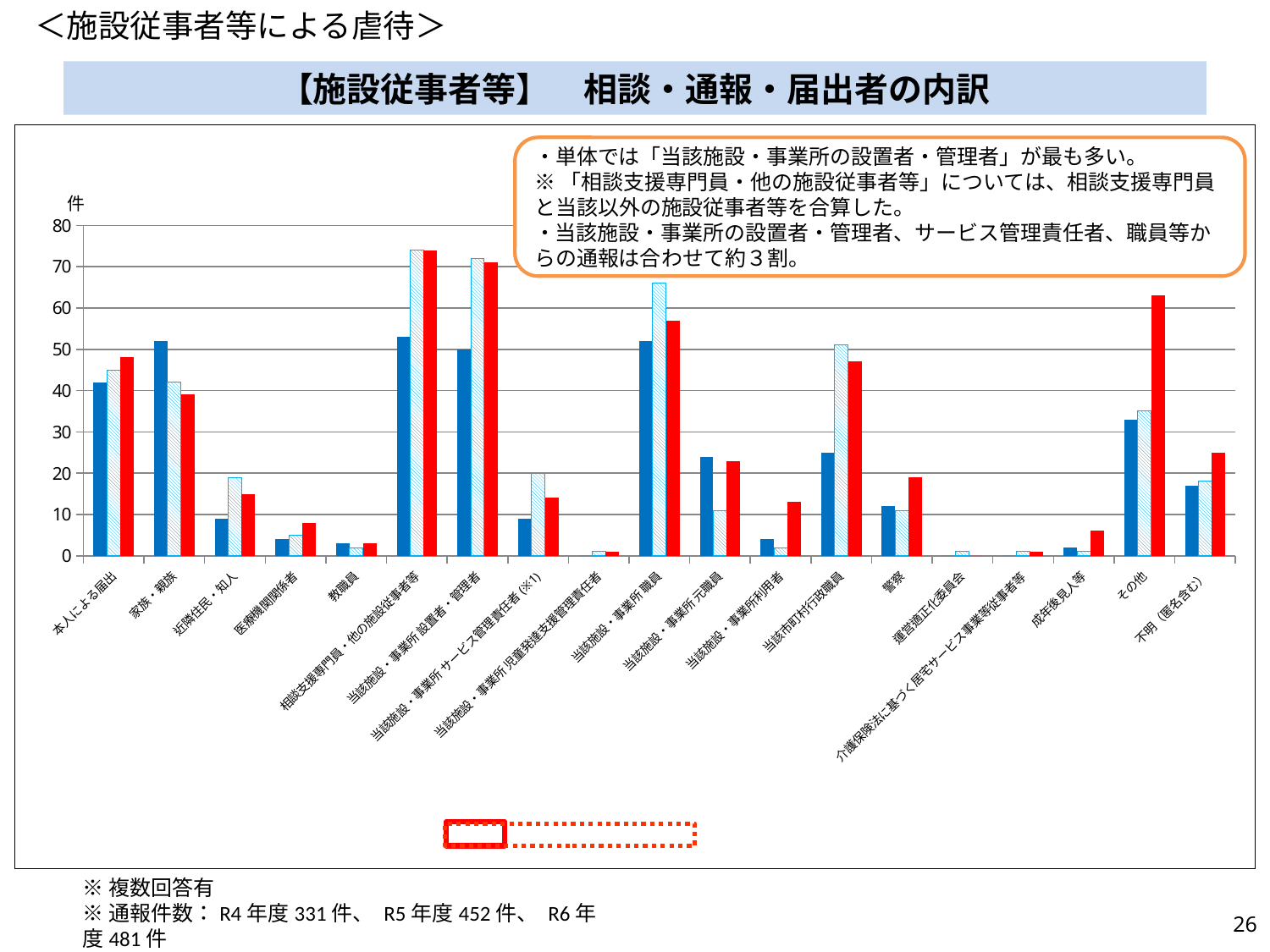
Is the solid blue bar for 当該市町村行政職員 greater or less than 20? greater For the category 家族・親族, which is larger: the solid blue bar or the red bar? the solid blue bar What is the title shown above the chart? 【施設従事者等】 相談・通報・届出者の内訳 How many bars are plotted for each category in the chart? 3 Is the solid blue bar for 家族・親族 greater or less than 50? greater What unit is written at the top of the vertical axis? 件 Which is larger: the red bar for その他 or the red bar for 不明（匿名含む）? その他 Is the red bar for その他 greater or less than 60? greater What kind of chart is shown on the slide? bar chart How many categories are shown along the x axis of the chart? 19